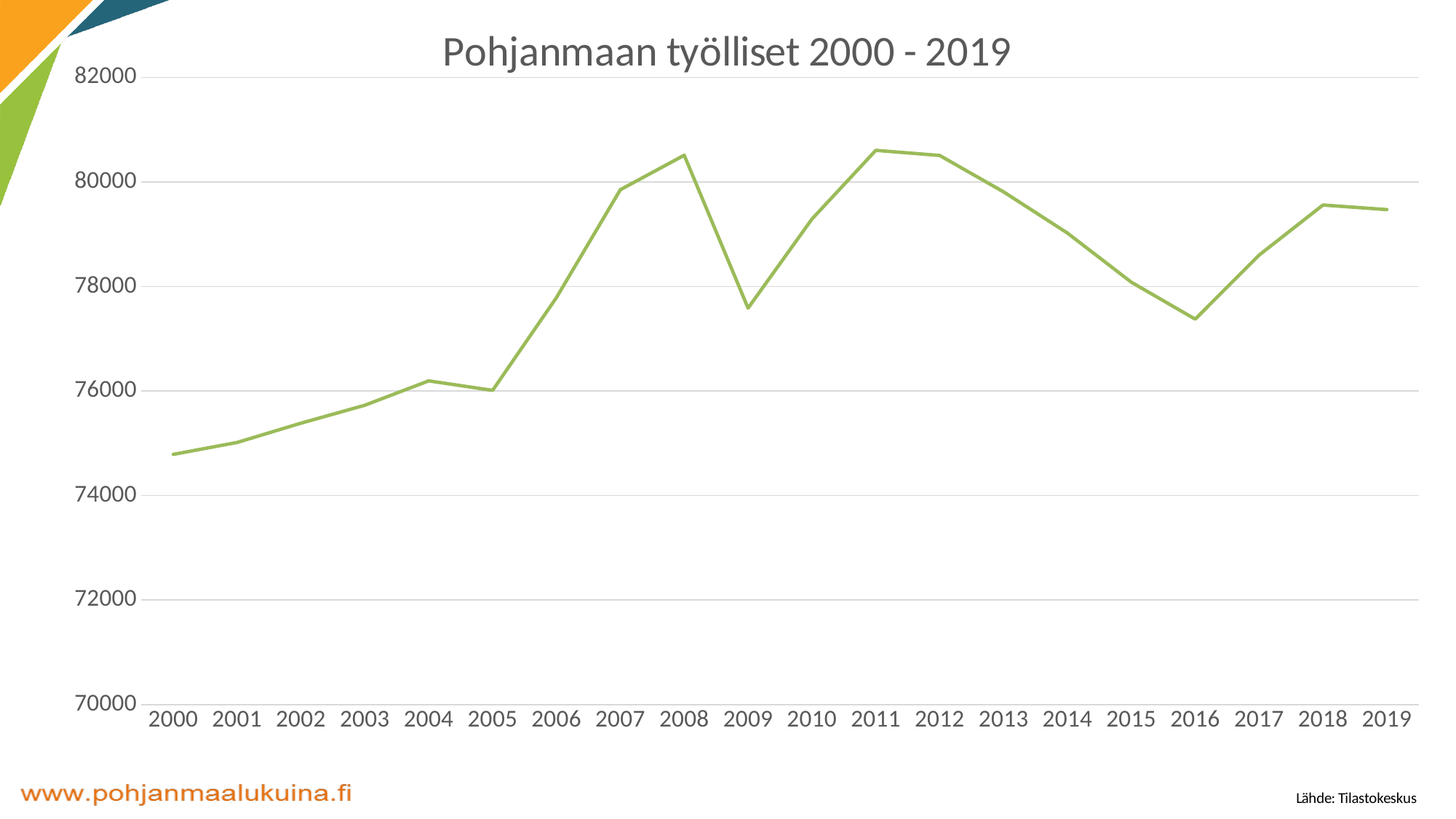
What kind of chart is shown on the slide? line chart Which is larger, the value for 2000 or the value for 2019? 2019 Is the value for 2011 greater or less than 80000? greater Is the value for 2009 greater or less than 78000? less Which is larger, the value for 2008 or the value for 2009? 2008 Is the value for 2014 greater or less than 78000? greater Which year has the lowest value? 2000 Do the values rise or fall from 2012 to 2016? fall How many years are plotted on the x axis? 20 What is the title of the chart? Pohjanmaan työlliset 2000 - 2019